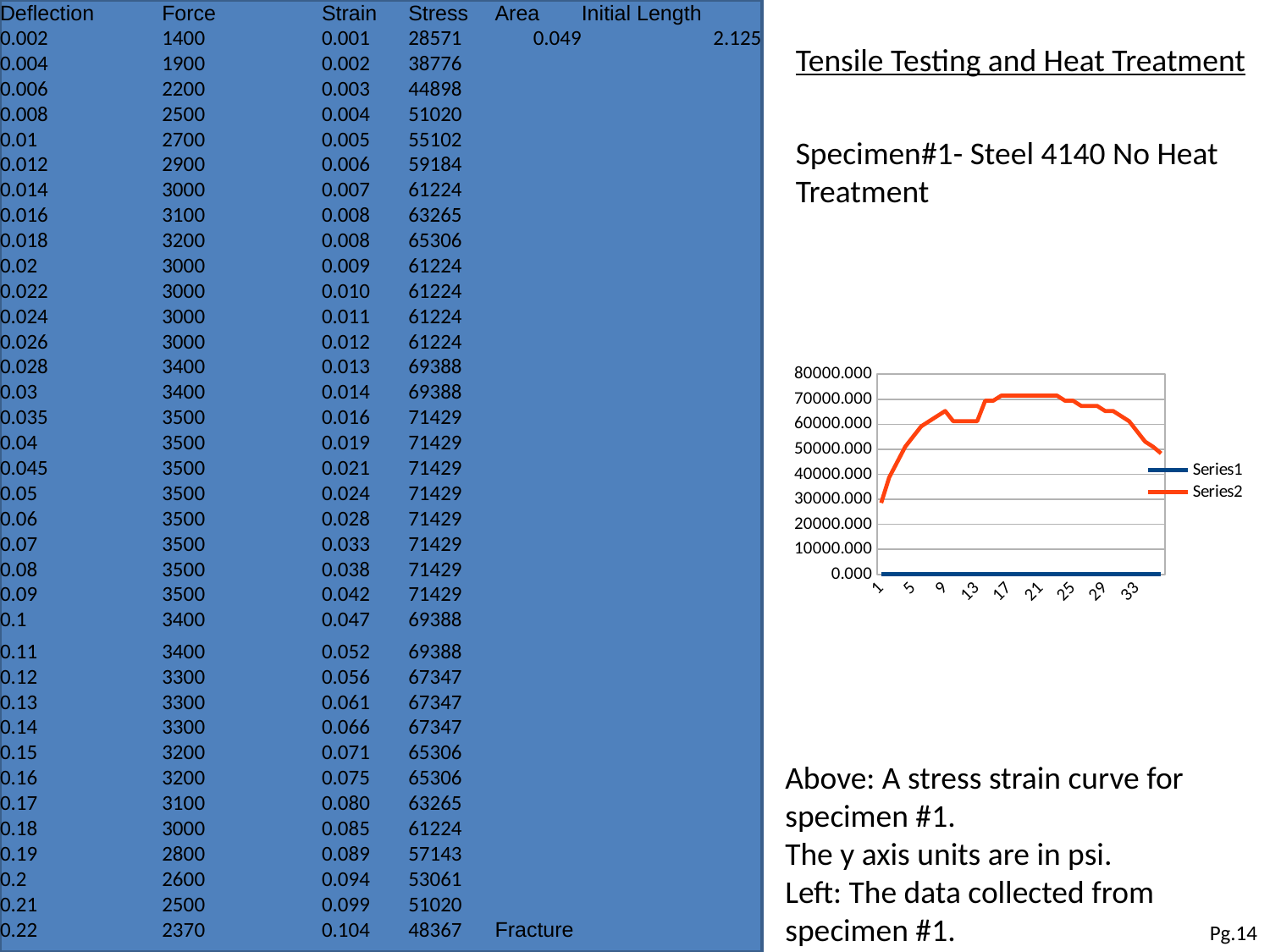
What colour is the Series2 line in the chart? orange What kind of chart is shown on the slide? line chart What are the names of the series in the chart legend? Series1 and Series2 Is the value of Series2 at point 1 greater or less than 40000? less Is the value of Series2 at point 9 greater or less than 50000? greater Is the value of Series2 larger at point 1 or at point 33? point 33 How many series does the chart legend list? 2 At which point does Series2 reach its lowest value? 1 Which series has the higher values across the chart, Series1 or Series2? Series2 How does Series2 change along the x axis? rises then falls Is the value of Series1 at point 5 greater or less than 10000? less